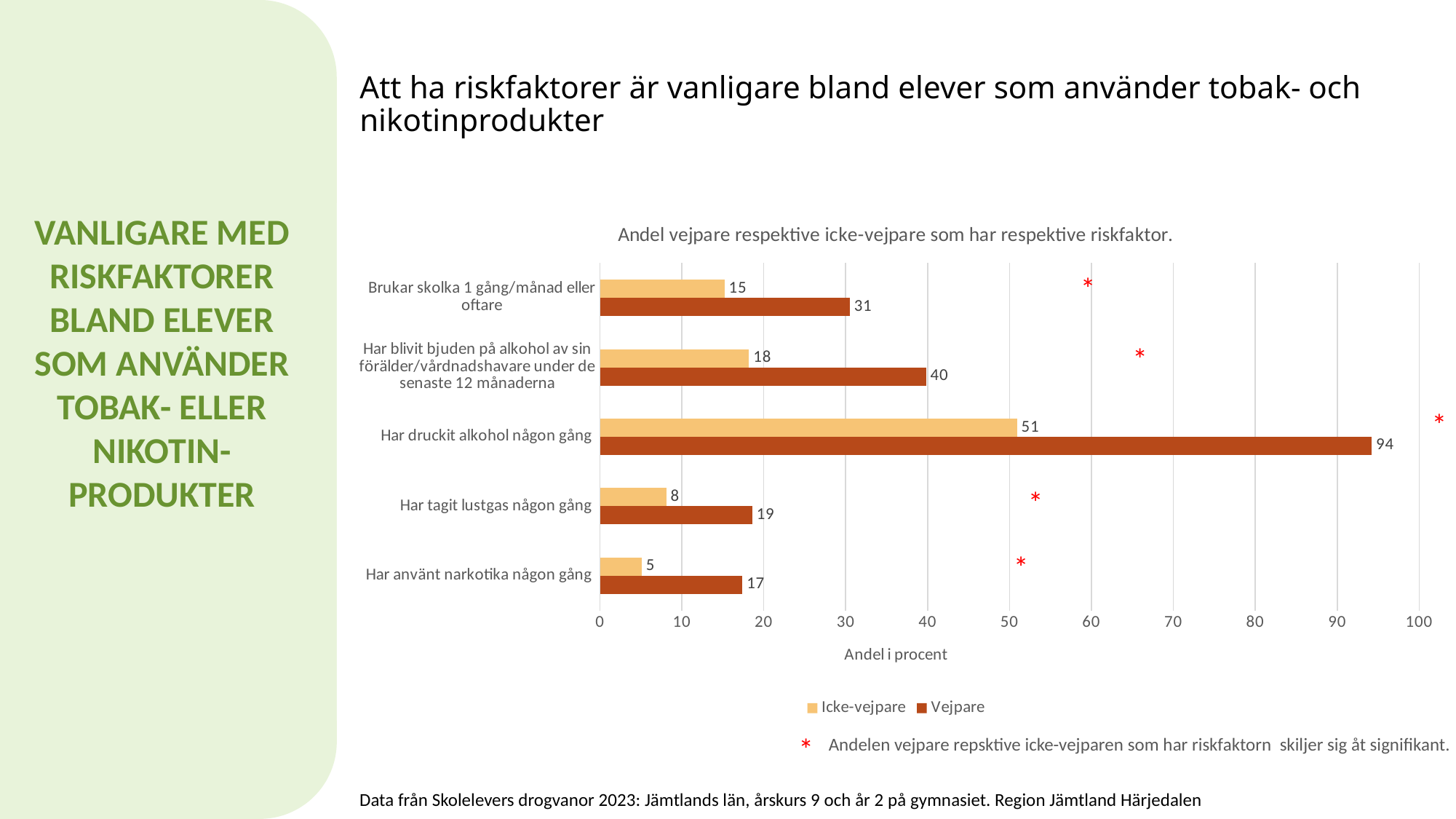
How many categories are shown on the chart? 5 What is the difference between the Vejpare and Icke-vejpare values for 'Har blivit bjuden på alkohol av sin förälder/vårdnadshavare under de senaste 12 månaderna'? 22 What kind of chart is shown on the slide? Bar chart What is the value for Vejpare in the category 'Har druckit alkohol någon gång'? 94 What is the value for Icke-vejpare in the category 'Brukar skolka 1 gång/månad eller oftare'? 15 What is the value for Vejpare in the category 'Har tagit lustgas någon gång'? 19 How many series does the legend list? 2 What is the title of the chart? Andel vejpare respektive icke-vejpare som har respektive riskfaktor. Which category has the lowest value for Vejpare? Har använt narkotika någon gång Which category has the highest value for Icke-vejpare? Har druckit alkohol någon gång Which is larger: the Vejpare value for 'Har använt narkotika någon gång' or the Icke-vejpare value for 'Har blivit bjuden på alkohol av sin förälder/vårdnadshavare under de senaste 12 månaderna'? Icke-vejpare value for 'Har blivit bjuden på alkohol...' (18) What is the label of the horizontal axis? Andel i procent